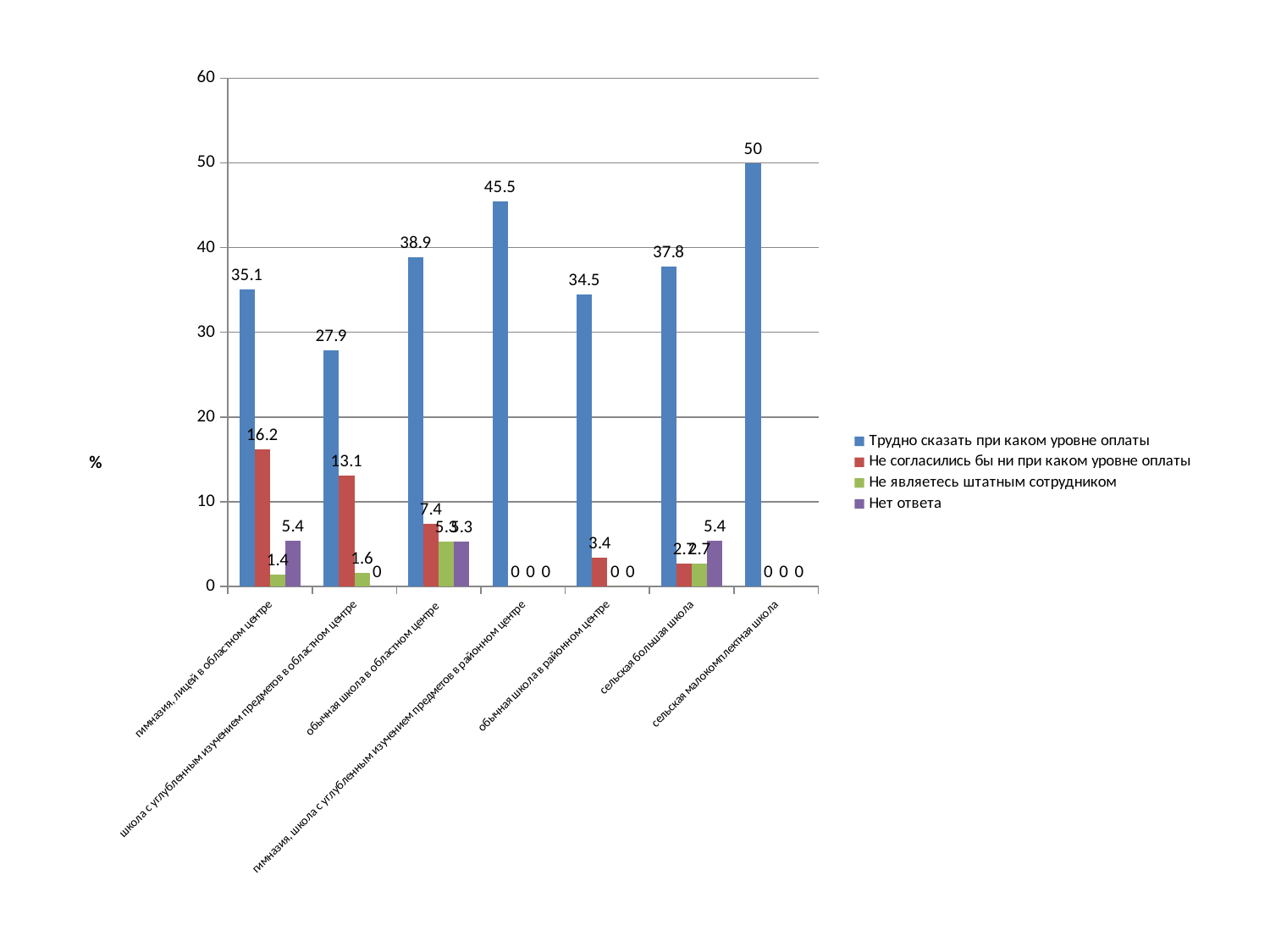
How many school-type categories are shown on the x axis? 7 What type of chart is shown on the slide? bar chart Is the "Трудно сказать при каком уровне оплаты" value for "обычная школа в областном центре" greater or less than 40? less What is the value of "Трудно сказать при каком уровне оплаты" for "гимназия, школа с углубленным изучением предметов в районном центре"? 45.5 What label is shown on the vertical axis? % What is the difference between the "Трудно сказать при каком уровне оплаты" values for "сельская малокомплектная школа" and "гимназия, лицей в областном центре"? 14.9 Which category has the highest value for "Трудно сказать при каком уровне оплаты"? сельская малокомплектная школа What is the value of "Не согласились бы ни при каком уровне оплаты" for "гимназия, лицей в областном центре"? 16.2 Which category has the lowest value for "Трудно сказать при каком уровне оплаты"? школа с углубленным изучением предметов в областном центре What is the value of "Трудно сказать при каком уровне оплаты" for "сельская малокомплектная школа"? 50 How many series does the legend list? 4 Which is larger: the "Не согласились бы ни при каком уровне оплаты" value for "гимназия, лицей в областном центре" or for "школа с углубленным изучением предметов в областном центре"? гимназия, лицей в областном центре